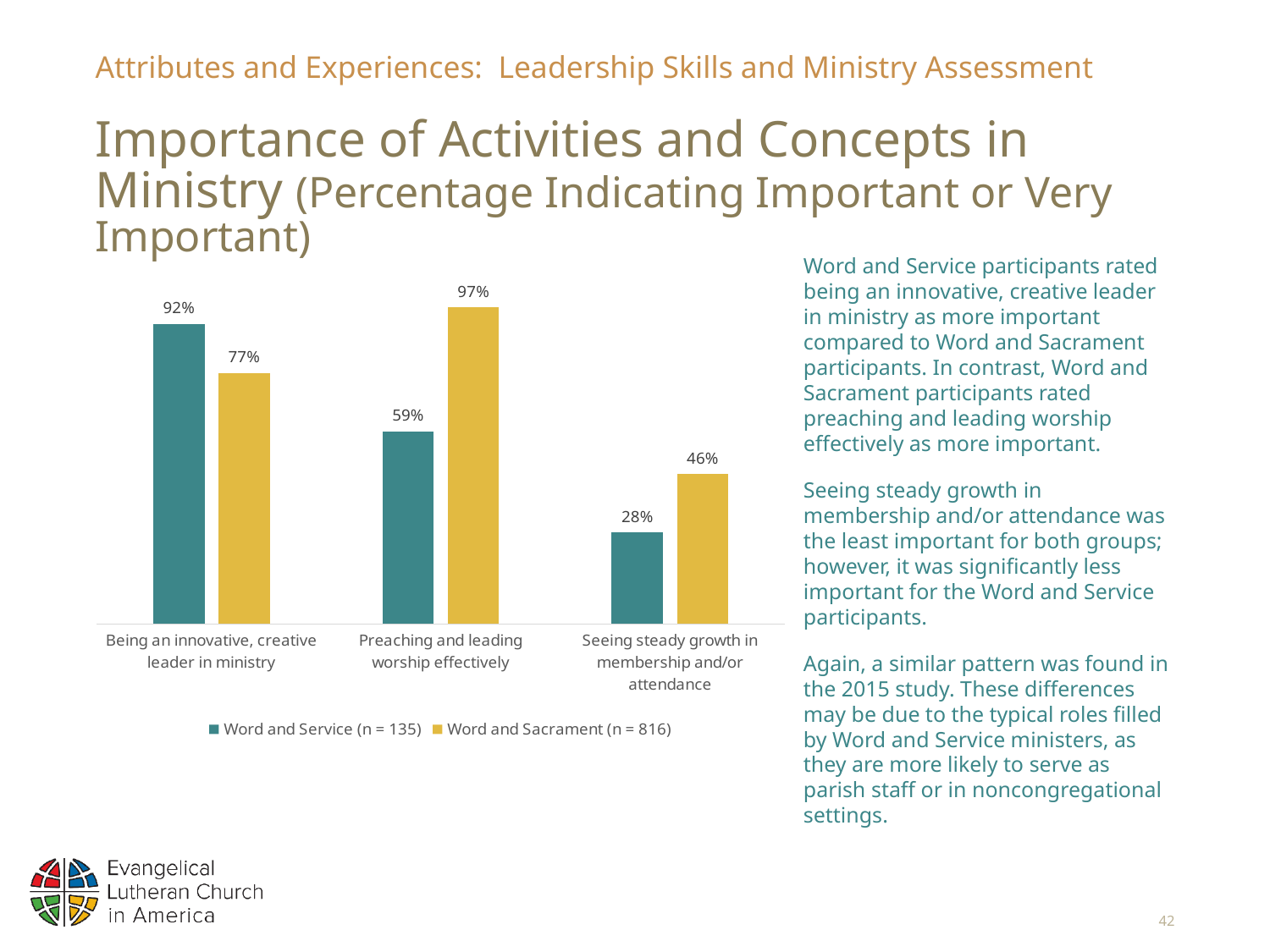
What is the sample size (n) for the Word and Sacrament series shown in the legend? 816 What is the value for Word and Service for seeing steady growth in membership and/or attendance? 28% How many categories are shown on the x axis of the chart? 3 What kind of chart is shown on the slide? Bar chart What percentage of Word and Service participants rated being an innovative, creative leader in ministry as important or very important? 92% How many series does the legend list? 2 Which category has the highest value for Word and Service participants? Being an innovative, creative leader in ministry What is the value for Word and Sacrament for being an innovative, creative leader in ministry? 77% Which category has the lowest value for Word and Sacrament participants? Seeing steady growth in membership and/or attendance Which group has the larger value for seeing steady growth in membership and/or attendance? Word and Sacrament What percentage of Word and Sacrament participants rated preaching and leading worship effectively as important or very important? 97% What is the difference between the Word and Sacrament and Word and Service values for preaching and leading worship effectively? 38%